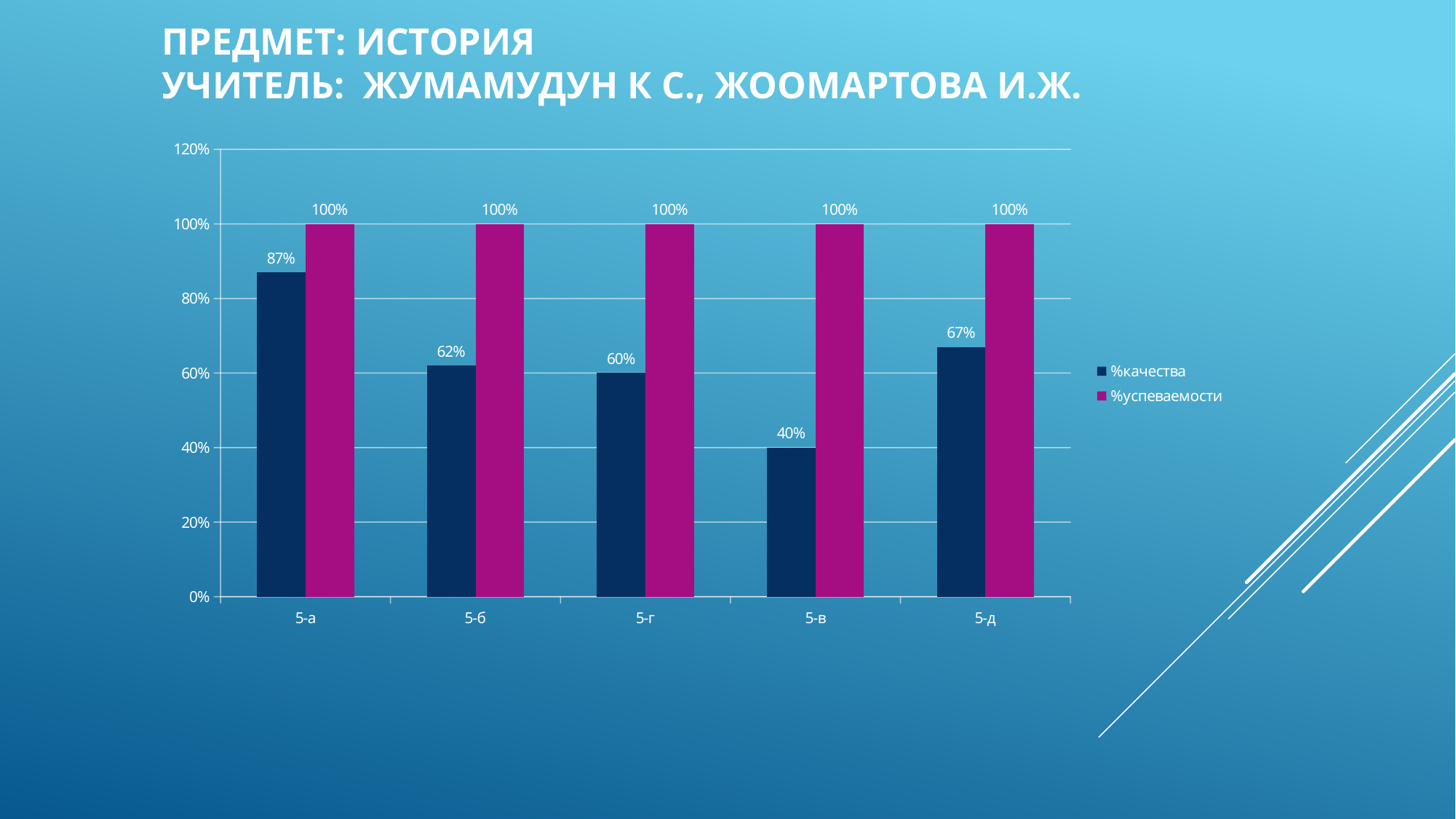
Which class has the highest %качества? 5-а What is the %качества value for class 5-в? 40% What is the %качества value for class 5-а? 87% Is the %качества value for 5-г greater or less than 80%? less What is the %успеваемости value for class 5-д? 100% How many classes are shown on the x axis? 5 Which class has a higher %качества, 5-б or 5-д? 5-д What is the difference between the %качества values for 5-а and 5-в? 47% What kind of chart is shown on the slide? bar chart What colour are the %успеваемости bars? magenta How many series does the legend list? 2 Which class has the lowest %качества? 5-в